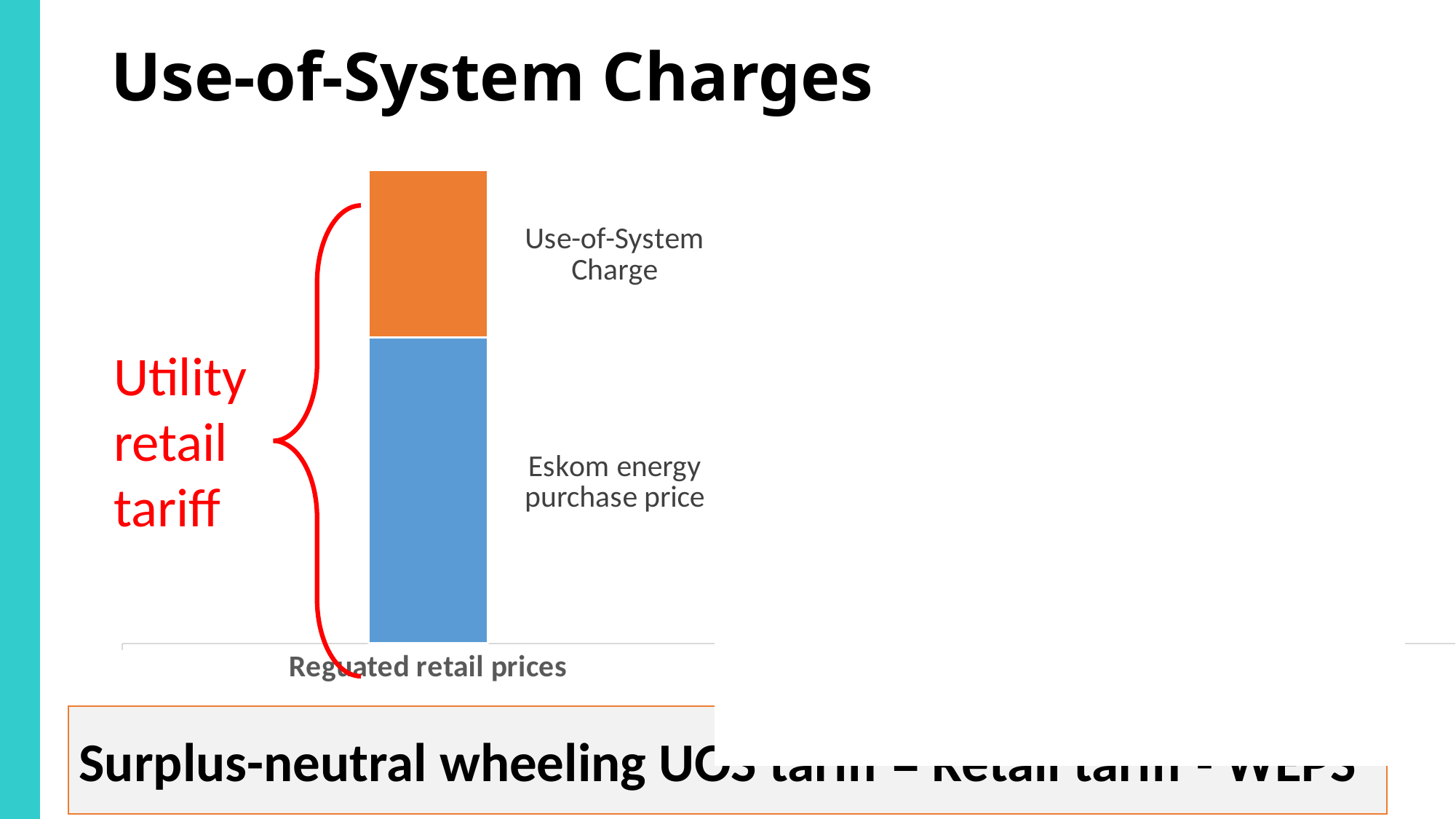
Which segment of the stacked bar is the smallest? Use-of-System Charge Which segment of the stacked bar is larger: Use-of-System Charge or Eskom energy purchase price? Eskom energy purchase price According to the red annotation, what does the whole stacked bar represent? Utility retail tariff What colour is the Use-of-System Charge segment of the bar? Orange How many segments make up the stacked bar in the chart? 2 Which segment sits at the bottom of the stacked bar? Eskom energy purchase price Which segment of the stacked bar is the largest? Eskom energy purchase price What kind of chart is shown on the slide? Stacked bar chart How many categories are plotted on the x axis of the chart? 1